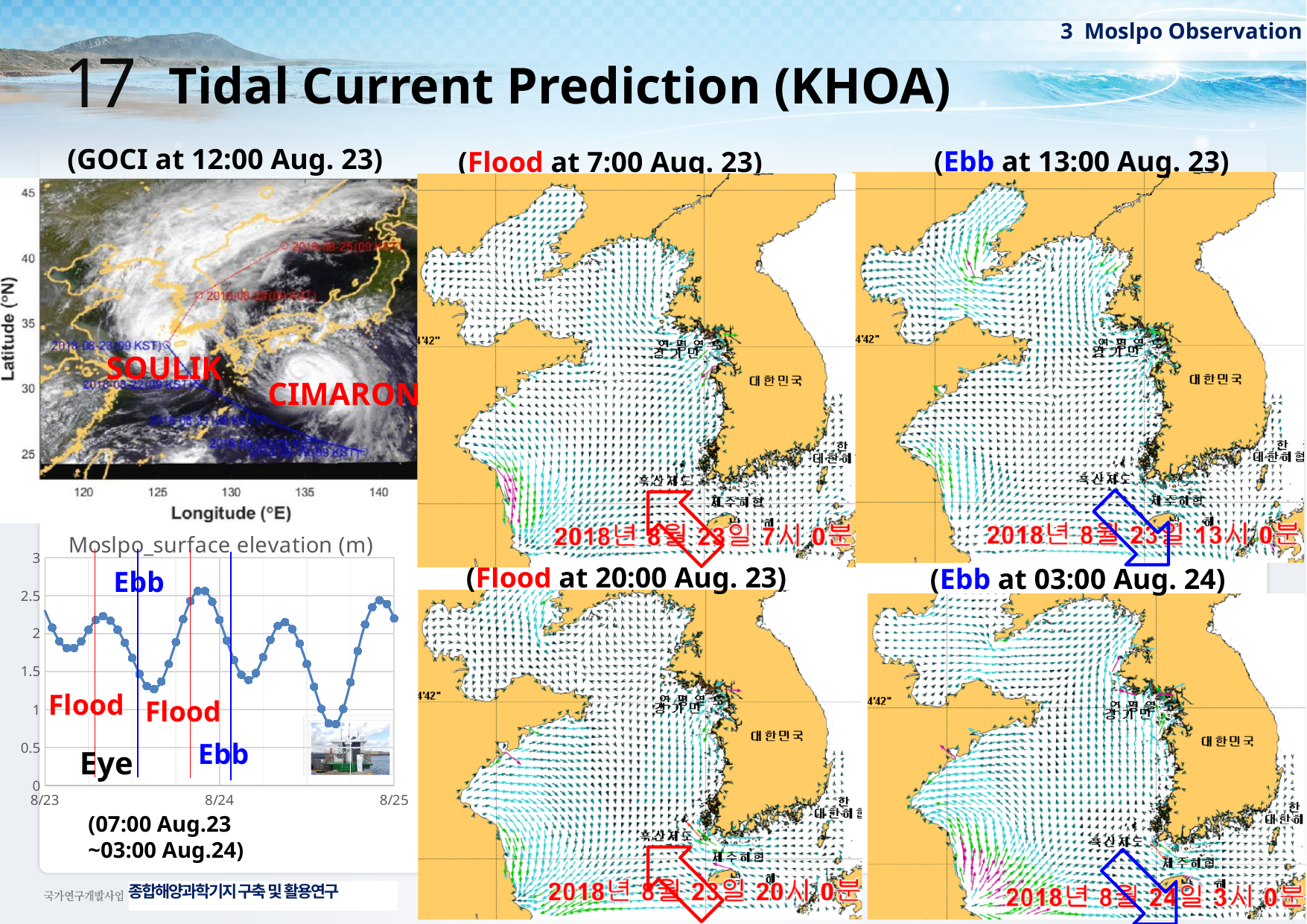
How many data series are plotted in the Moslpo_surface elevation chart? 1 What dates are labelled on the x-axis of the Moslpo_surface elevation chart? 8/23, 8/24, 8/25 In the Moslpo_surface elevation chart, does the line rise or fall from the peak just before 8/24 to the trough between 8/24 and 8/25? fall In the Moslpo_surface elevation chart, which is larger: the peak just before 8/24 or the trough between 8/24 and 8/25? the peak just before 8/24 In the Moslpo_surface elevation chart, is the highest peak of the line (just before 8/24) greater or less than 2? greater In the Moslpo_surface elevation chart, is the lowest value of the line (between 8/24 and 8/25) greater or less than 1? less In the Moslpo_surface elevation chart, is the trough labelled near the first 'Ebb' line (between 8/23 and 8/24) greater or less than 1.5? less What is the title of the line chart on the lower left of the slide? Moslpo_surface elevation (m) What kind of chart is the Moslpo_surface elevation chart on the left of the slide? line chart What is the highest tick value shown on the y-axis of the Moslpo_surface elevation chart? 3